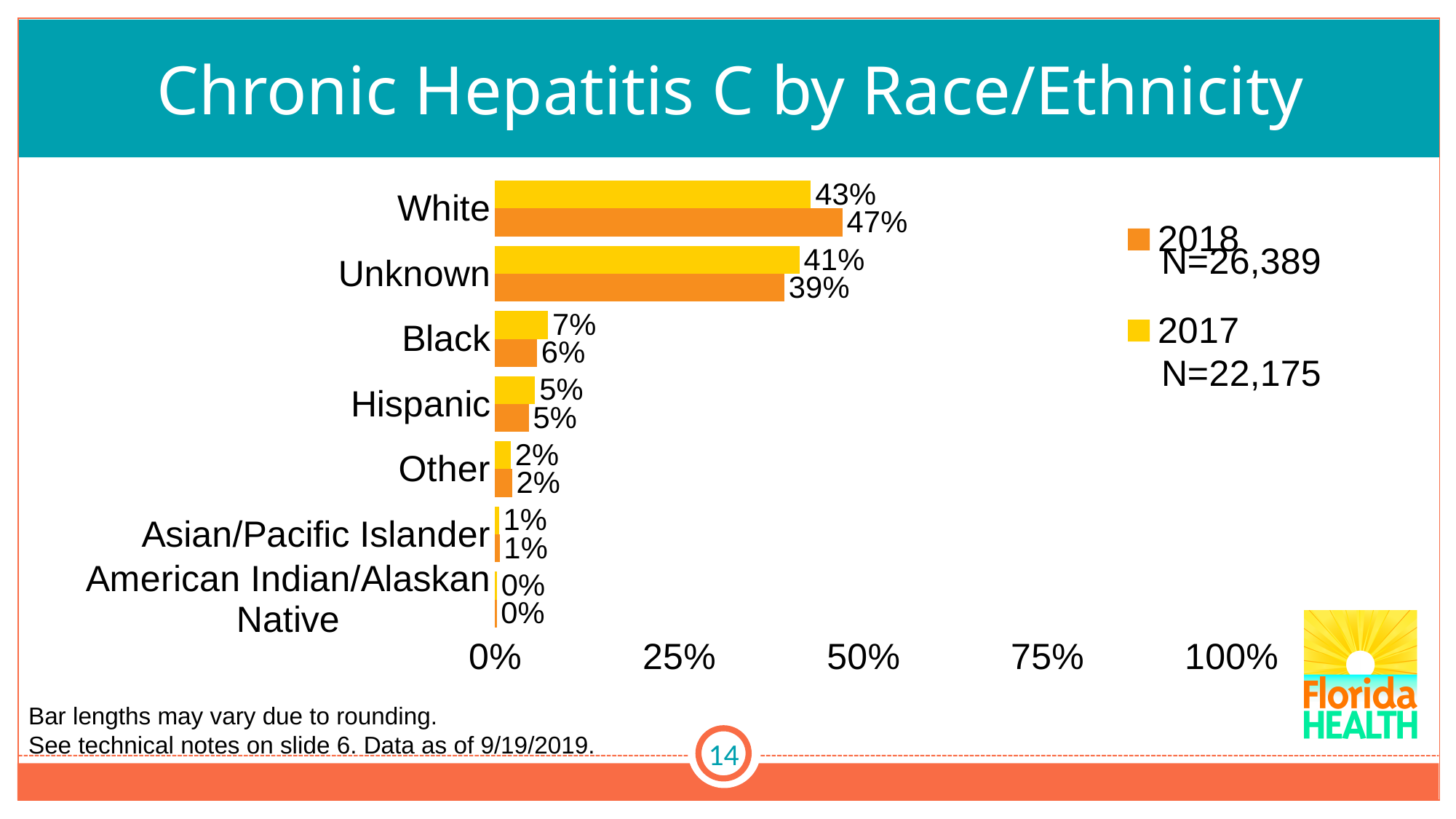
Which race/ethnicity category has the lowest 2017 value? American Indian/Alaskan Native Which race/ethnicity category has the highest 2018 value? White What is the N value shown in the legend for 2018? N=26,389 Which is larger for Unknown, the 2017 value or the 2018 value? 2017 How many race/ethnicity categories are shown on the chart? 7 What is the 2017 value for Unknown? 41% What is the difference between the 2018 and 2017 values for White? 4% How many series does the legend list? 2 What is the 2017 value for Hispanic? 5% What kind of chart is shown on the slide? Bar chart What is the 2018 value for White? 47% What is the 2018 value for Black? 6%